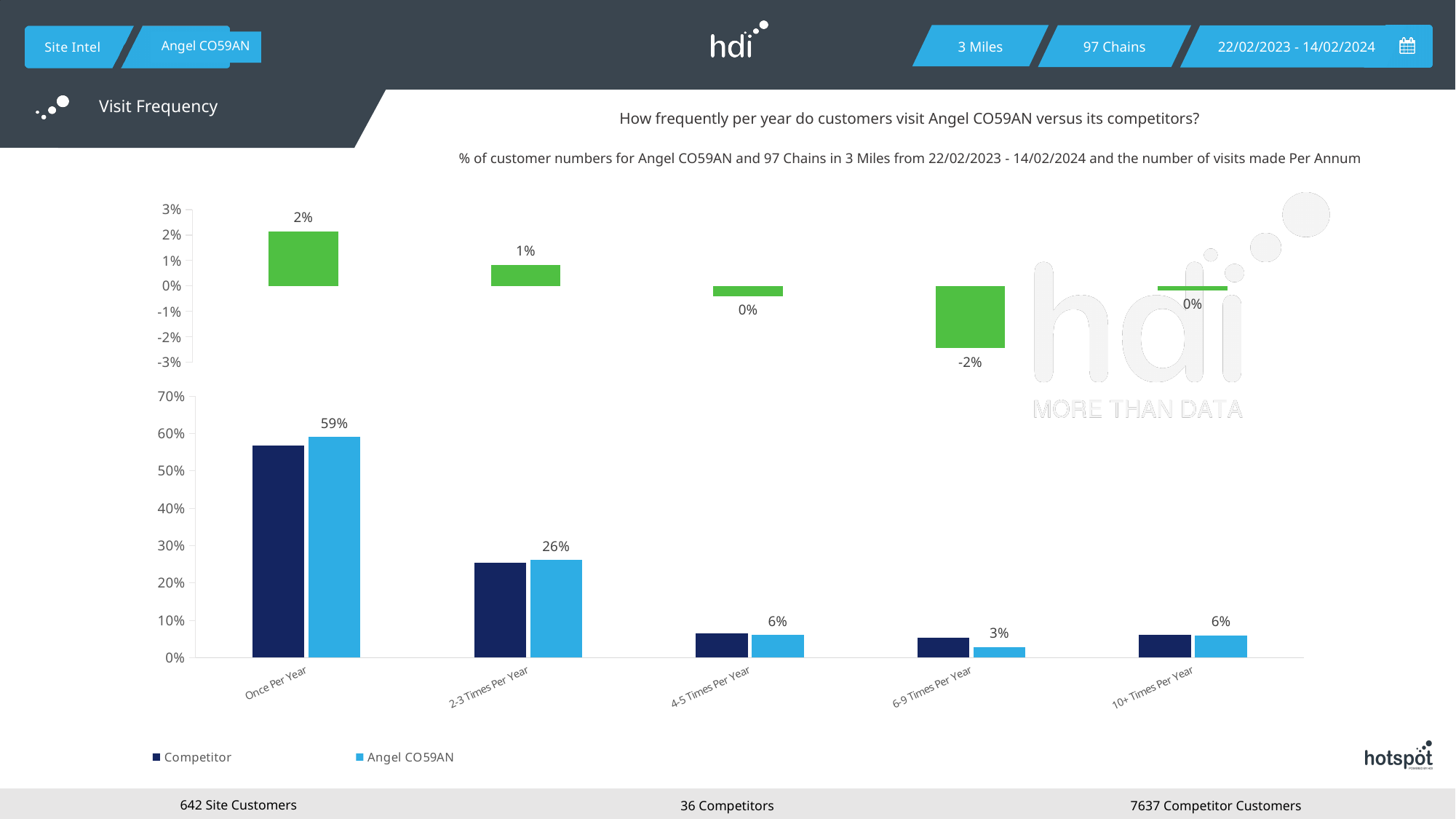
In the bottom chart, what is the difference between the Angel CO59AN values for Once Per Year and 2-3 Times Per Year? 33% In the bottom chart, which category has the highest Angel CO59AN value? Once Per Year In the bottom chart, what is the Angel CO59AN value for Once Per Year? 59% In the top chart, which category has the lowest value? 6-9 Times Per Year In the top chart, what is the value shown for 6-9 Times Per Year? -2% How many series does the legend of the bottom chart list? 2 In the bottom chart, what is the Angel CO59AN value for 6-9 Times Per Year? 3% In the top chart, what is the value shown for Once Per Year? 2% How many categories are shown on the x axis of the bottom chart? 5 In the bottom chart, is the Competitor value for Once Per Year greater or less than 50%? greater In the bottom chart, which category has the lowest Angel CO59AN value? 6-9 Times Per Year In the bottom chart, for Once Per Year, which series has the larger value: Competitor or Angel CO59AN? Angel CO59AN